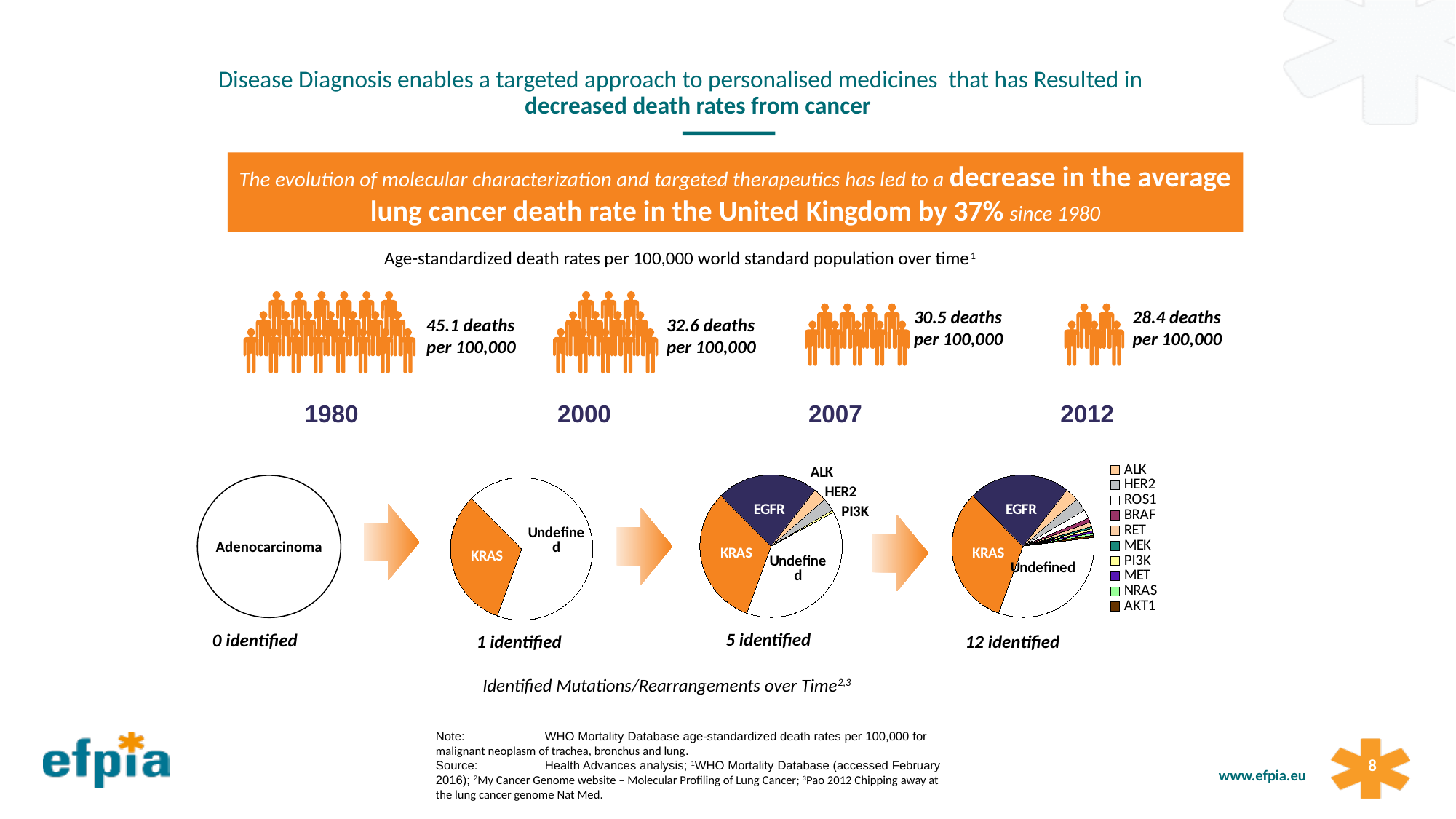
In the age-standardized death rate pictogram, what is the death rate shown for 1980? 45.1 deaths per 100,000 In the '1 identified' pie chart, which slice is larger, KRAS or Undefined? Undefined How many mutations/rearrangements are identified in the third pie chart from the left? 5 identified How many pie charts are shown in the 'Identified Mutations/Rearrangements over Time' row? 4 In the age-standardized death rate pictogram, what is the difference between the 1980 and 2012 death rates? 16.7 deaths per 100,000 Does the number of identified mutations rise or fall across the pie charts from left to right? Rise In the '5 identified' pie chart, which slice is larger, EGFR or KRAS? KRAS In the '12 identified' pie chart, which slice is larger, KRAS or EGFR? KRAS What is the label of the single slice in the leftmost pie chart? Adenocarcinoma How many entries does the legend next to the '12 identified' pie chart list? 10 What is the first entry in the legend beside the rightmost pie chart? ALK What kind of chart is used to show the identified mutations/rearrangements over time? Pie chart